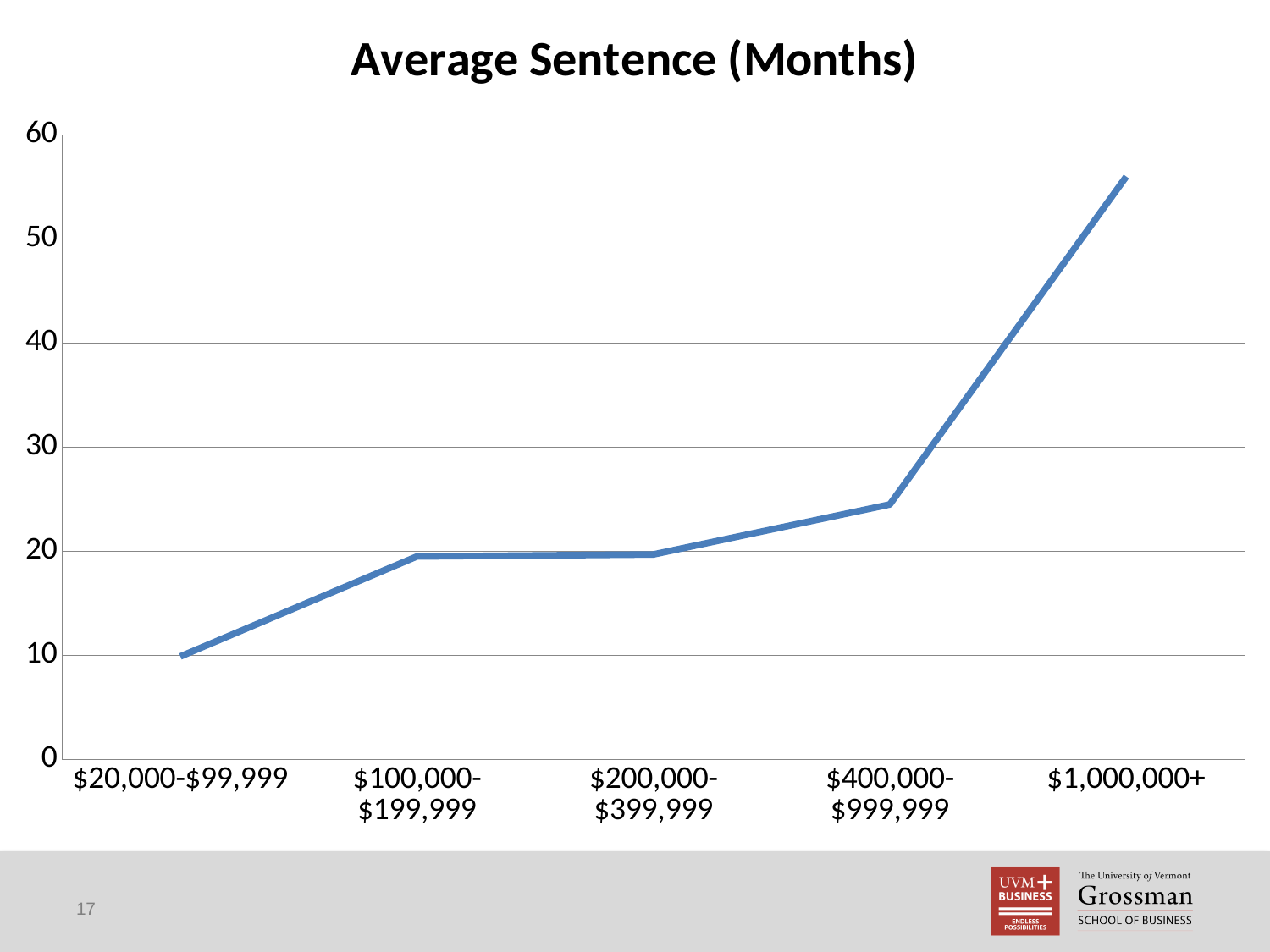
Is the value for $400,000-$999,999 greater or less than 20? greater Do the values rise or fall as the loss amount increases along the x axis? rise Is the value for $200,000-$399,999 greater or less than 30? less Is the value for $1,000,000+ greater or less than 50? greater What is the title of the chart? Average Sentence (Months) Which category has the highest average sentence? $1,000,000+ What kind of chart is shown on the slide? line chart Which category has the lowest average sentence? $20,000-$99,999 How many loss-amount categories are plotted along the x axis? 5 Which has a larger average sentence, $1,000,000+ or $400,000-$999,999? $1,000,000+